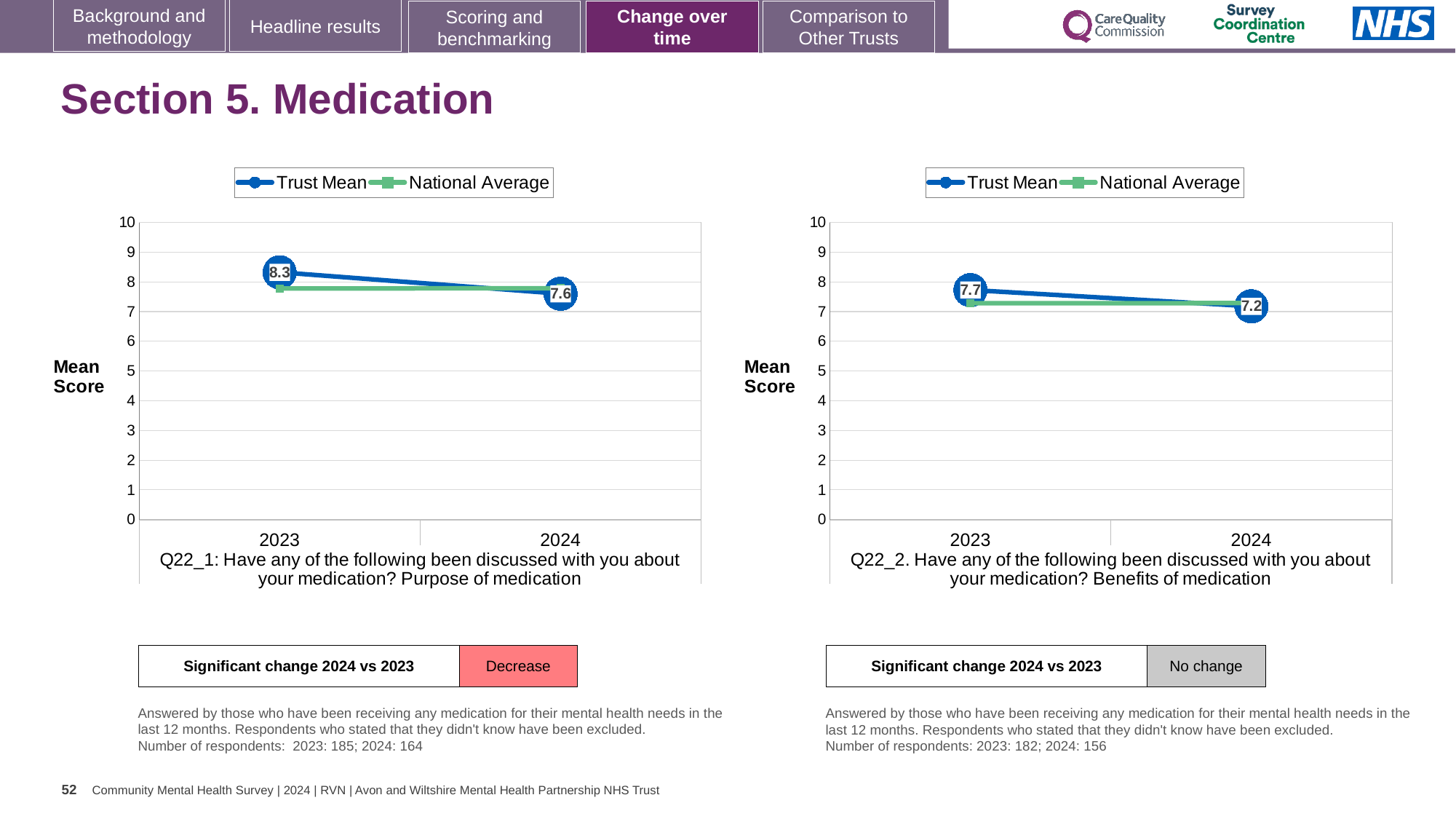
In the right chart (Q22_2: Benefits of medication), what is the Trust Mean score for 2024? 7.2 In the right chart (Q22_2: Benefits of medication), what is the Trust Mean score for 2023? 7.7 In the left chart (Q22_1), by how much did the Trust Mean score fall from 2023 to 2024? 0.7 In the left chart (Q22_1: Purpose of medication), what is the Trust Mean score for 2023? 8.3 In the right chart (Q22_2), what is the difference between the Trust Mean scores for 2023 and 2024? 0.5 What kind of chart is the left chart (Q22_1)? line chart In the left chart (Q22_1), is the National Average value for 2023 greater or less than 7? greater In the right chart (Q22_2), is the Trust Mean for 2023 higher or lower than the Trust Mean for 2024? higher In the left chart (Q22_1: Purpose of medication), what is the Trust Mean score for 2024? 7.6 In the left chart (Q22_1), does the Trust Mean rise or fall from 2023 to 2024? fall How many years are plotted on the x axis of the right chart (Q22_2)? 2 How many series does the legend of the right chart (Q22_2) list? 2